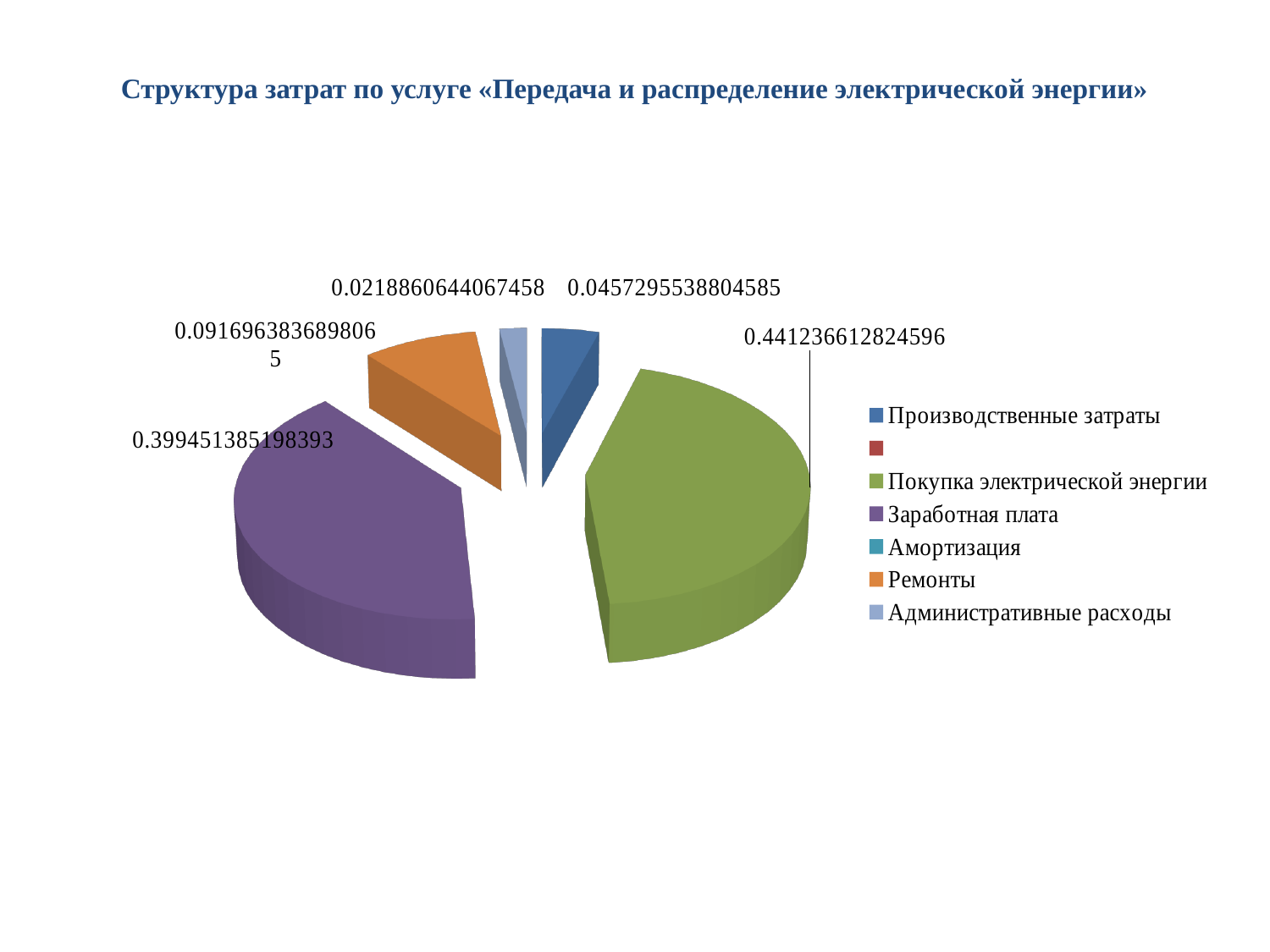
What is the value shown for Производственные затраты? 0.0457295538804585 What is the value shown for Покупка электрической энергии? 0.441236612824596 What is the value shown for Административные расходы? 0.0218860644067458 What is the title of the chart? Структура затрат по услуге «Передача и распределение электрической энергии» How many slices with data labels are shown in the pie chart? 5 What is the value shown for Заработная плата? 0.399451385198393 Which category has the largest slice of the pie? Покупка электрической энергии Which labelled category has the smallest slice of the pie? Административные расходы What kind of chart is shown on the slide? Pie chart What is the difference between the values for Покупка электрической энергии and Заработная плата? 0.041785227626203 What is the value shown for Ремонты? 0.0916963836898065 Which is larger, the value for Ремонты or the value for Производственные затраты? Ремонты